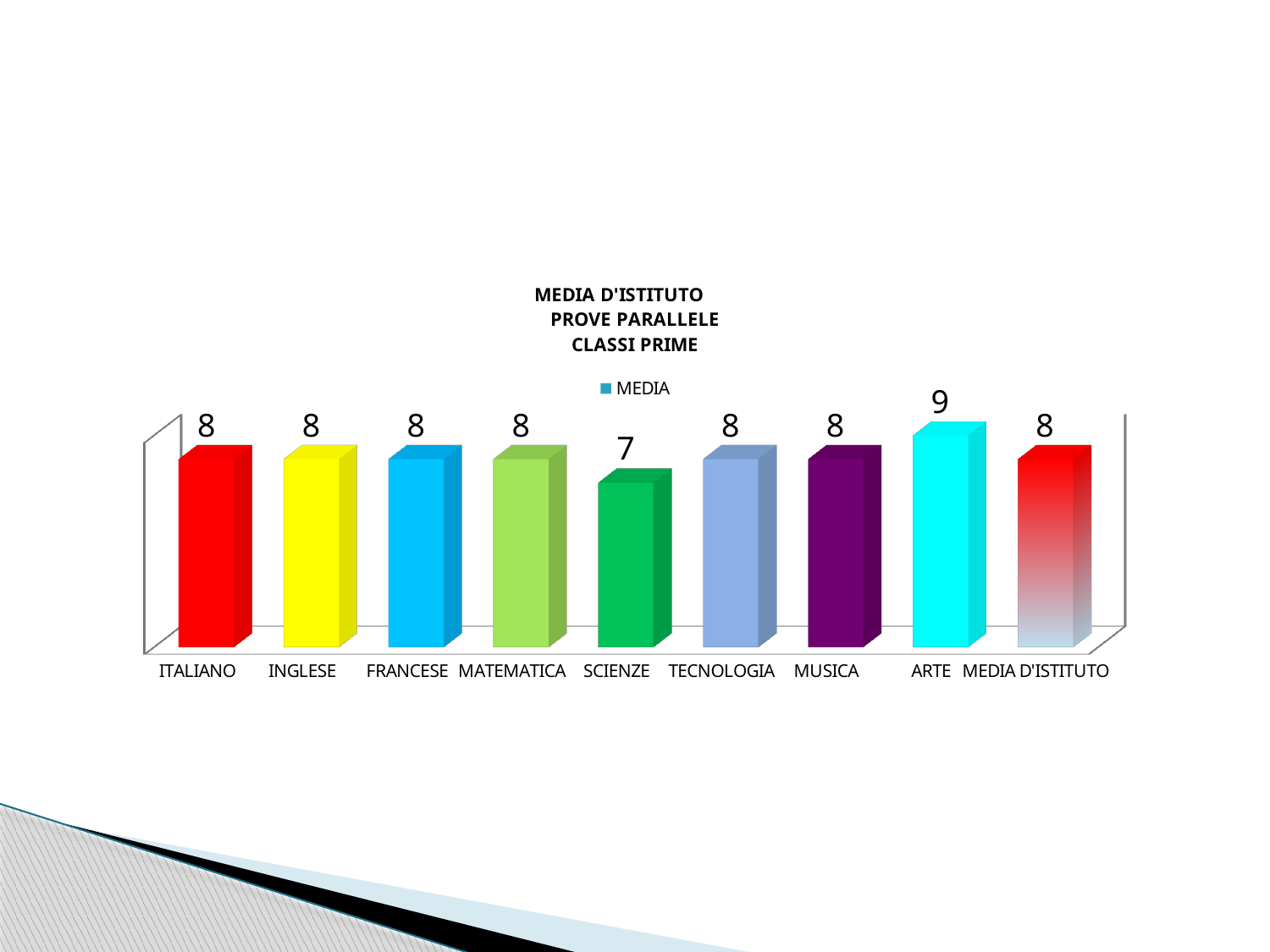
Which category has the lowest value? SCIENZE What is the name of the series in the legend? MEDIA What is the value for SCIENZE? 7 What is the value for MEDIA D'ISTITUTO? 8 How many series does the legend list? 1 What is the value for MATEMATICA? 8 What is the value for ARTE? 9 Which is larger, the value for ARTE or the value for MUSICA? ARTE How many categories are shown on the x axis? 9 What kind of chart is shown on the slide? bar chart Which category has the highest value? ARTE What is the difference between the values for ARTE and SCIENZE? 2